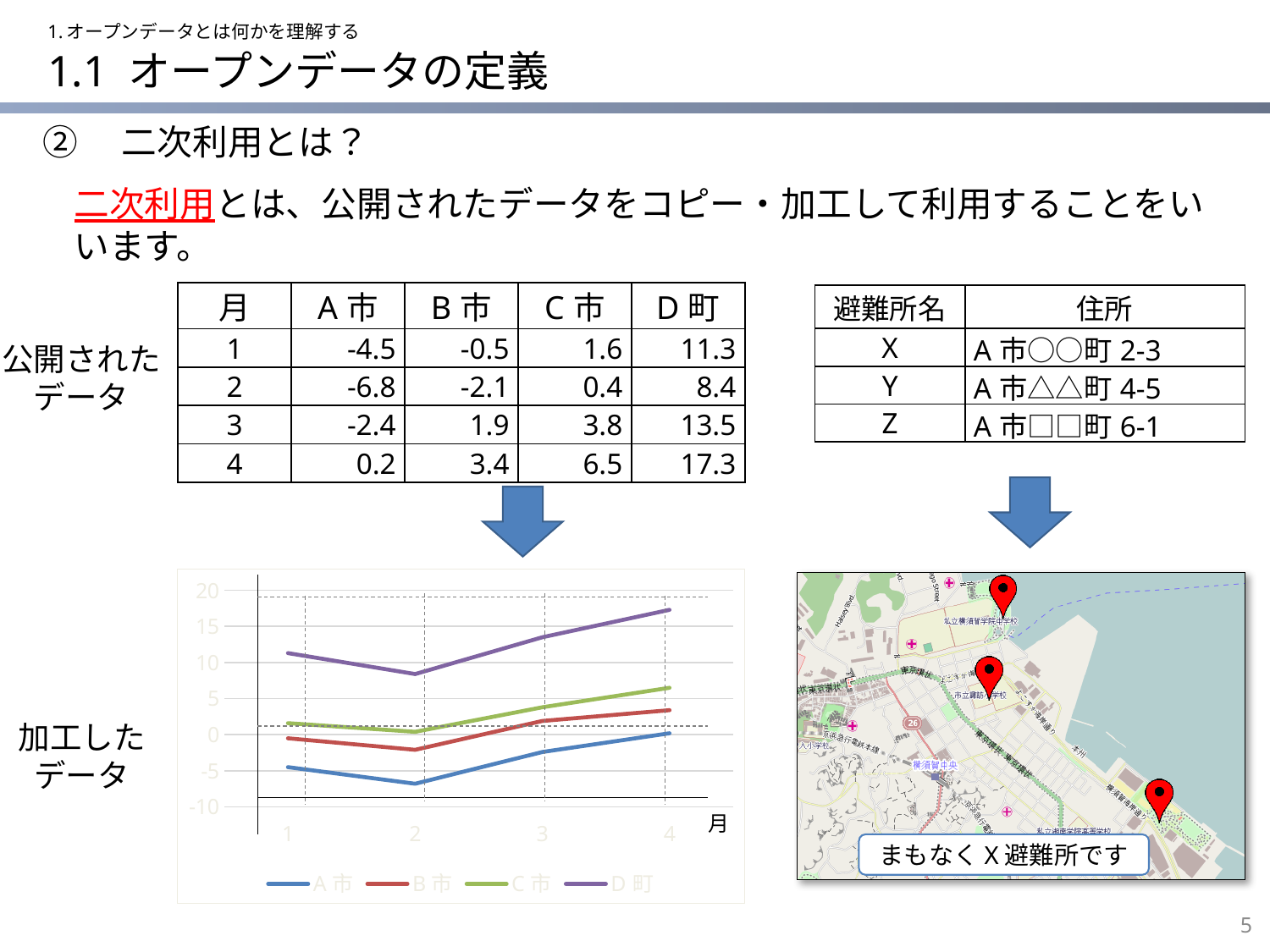
In the line chart, which is larger at month 3, B 市 or C 市? C 市 How many months are plotted along the x axis of the line chart? 4 How many series does the legend of the line chart list? 4 According to the published data table, what is the value for D 町 in month 4? 17.3 What kind of chart is shown at the bottom left of the slide? line chart According to the published data table, what is the value for A 市 in month 2? -6.8 In the line chart, which series has the lowest value at month 2? A 市 In the line chart, which series has the highest value at month 4? D 町 Using the values in the published data table, what is the difference between D 町 and A 市 in month 4? 17.1 In the line chart, is the value for A 市 at month 2 greater or less than -5? less In the line chart, is the value for D 町 at month 4 greater or less than 15? greater In the line chart, does the A 市 line rise or fall from month 2 to month 4? rise